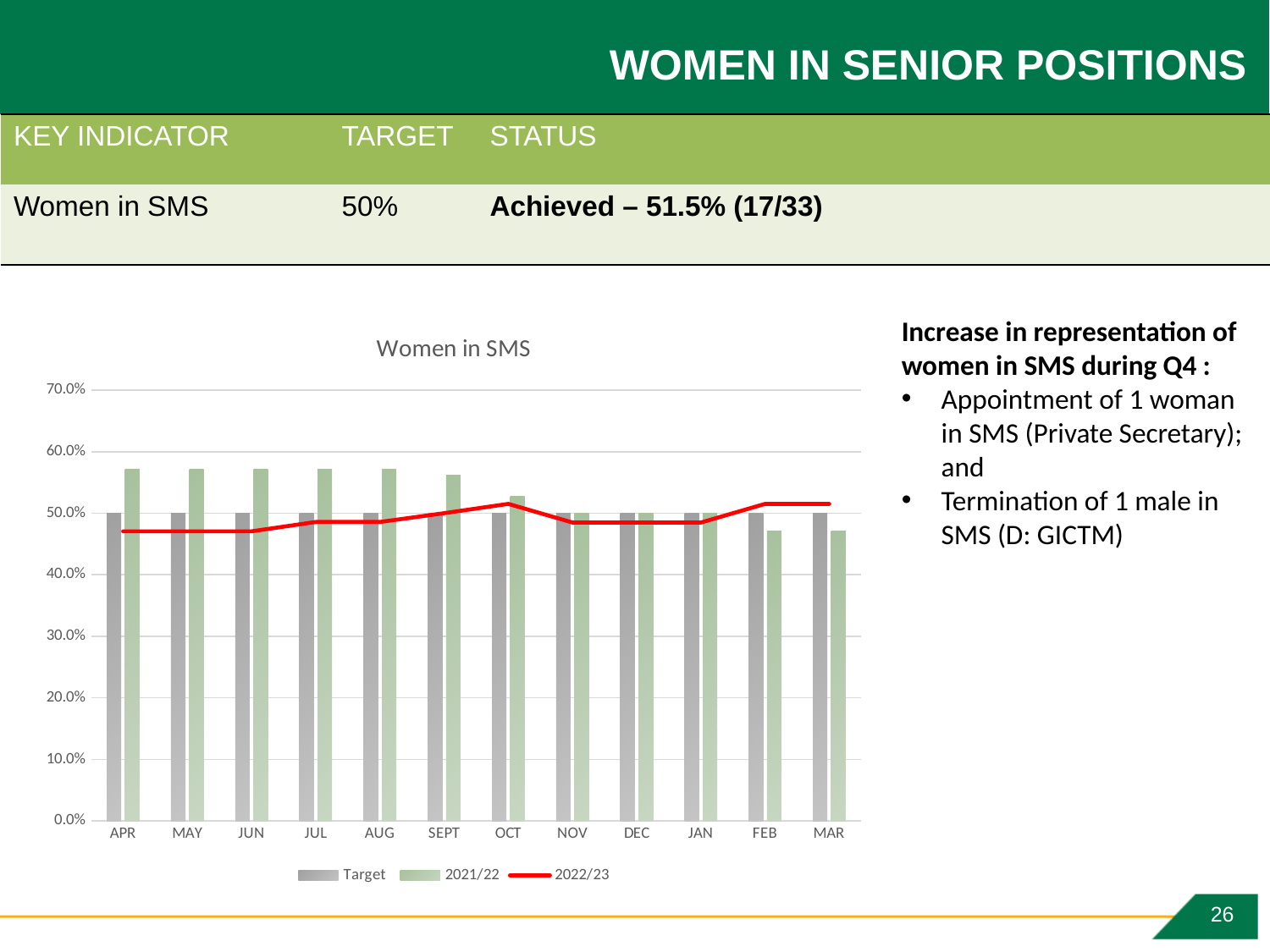
Is the 2022/23 value for FEB greater or less than 50.0%? greater What is the title of the chart? Women in SMS Which is larger, the 2021/22 value for APR or the 2021/22 value for MAR? APR Is the 2021/22 value for APR greater or less than 50.0%? greater Which series is drawn as a red line in the chart? 2022/23 Is the 2021/22 value for FEB greater or less than 50.0%? less What kind of chart is shown on the slide? Combined bar and line chart How many series does the chart legend list? 3 What is the Target value shown for APR? 50.0% How many months are shown on the x axis of the chart? 12 Do the 2021/22 values generally rise or fall from APR to MAR? fall